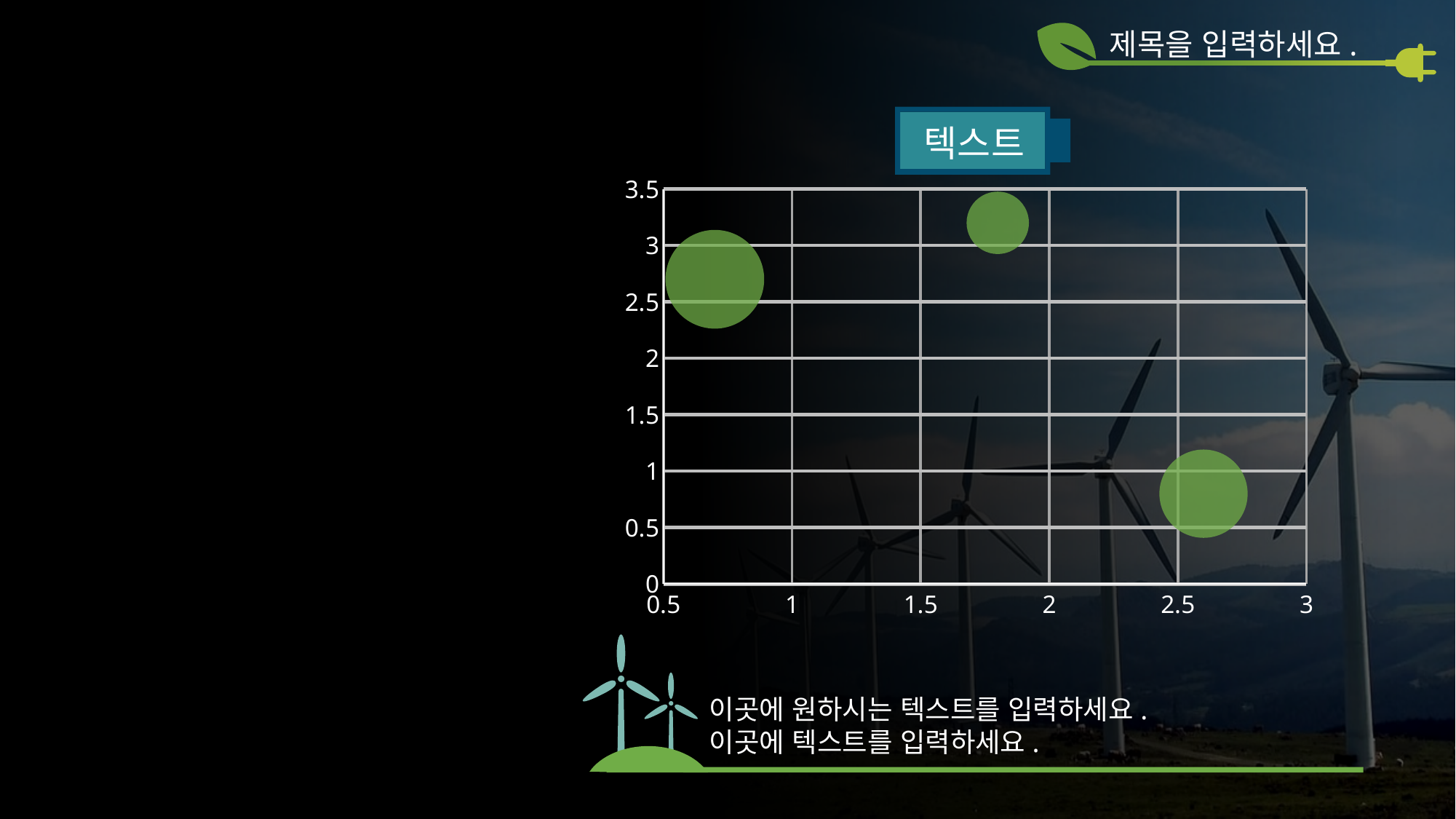
Is the horizontal-axis value of the rightmost bubble greater or less than 2? greater Is the vertical-axis value of the bubble located near x = 2.5 greater or less than 1.5? less What is the title shown above the chart? 텍스트 Is the vertical-axis value of the bubble located near x = 2 greater or less than 2.5? greater Which bubble has the lowest vertical-axis value: the leftmost, the middle, or the rightmost? the rightmost Which bubble has the highest vertical-axis value: the leftmost, the middle, or the rightmost? the middle What is the highest value shown on the vertical axis of the chart? 3.5 How many bubbles are plotted on the chart? 3 Which bubble is drawn largest: the leftmost, the middle, or the rightmost? the leftmost What kind of chart is shown on the slide? bubble chart